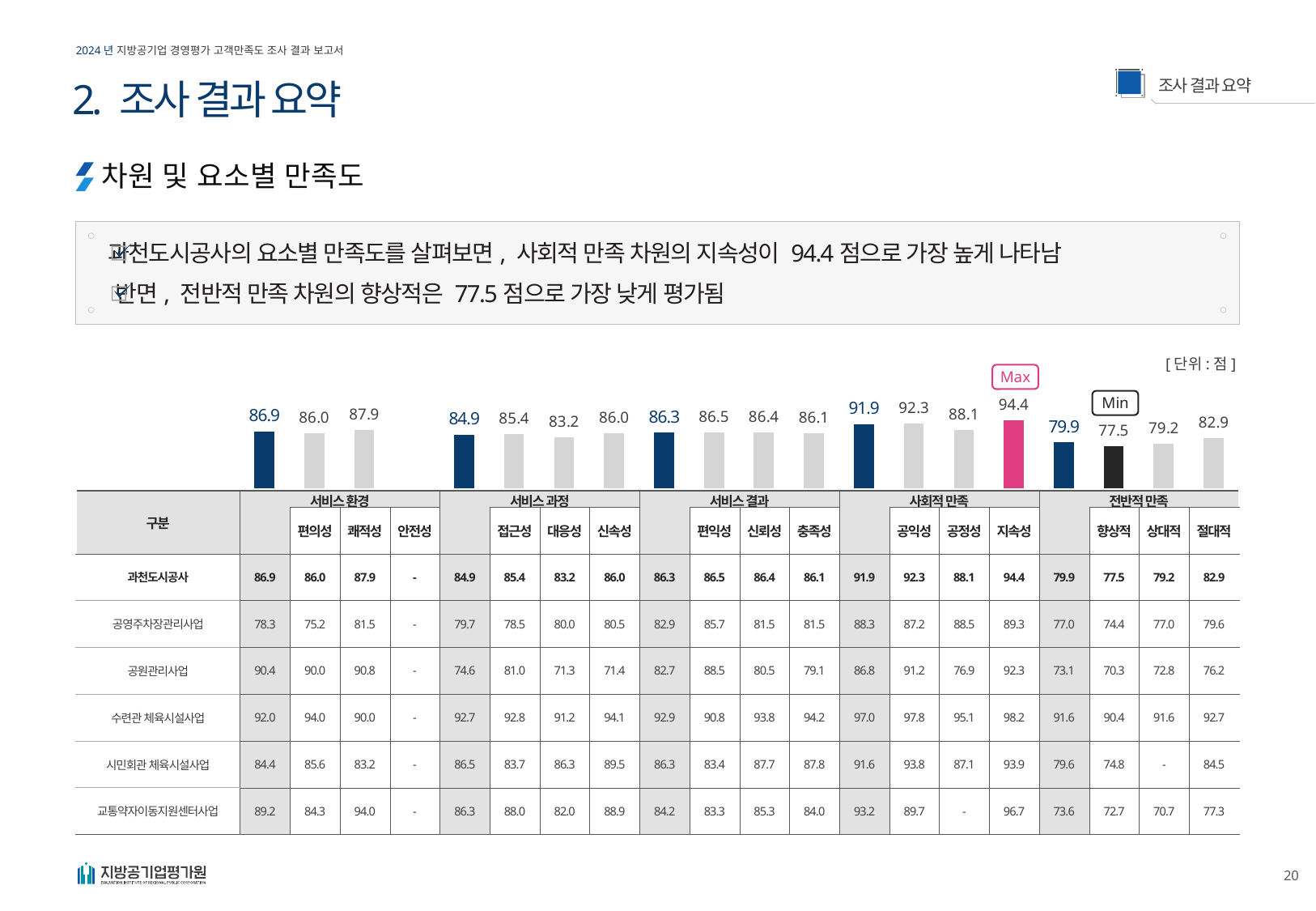
Which element has the lowest bar in the chart? 향상적 What is the difference between the highest bar (지속성) and the lowest bar (향상적)? 16.9 Which is larger, the bar for 쾌적성 or the bar for 편의성? 쾌적성 What is the value of the bar for 향상적 (전반적 만족)? 77.5 What is the value of the bar for 서비스 과정? 84.9 Among the five dimension bars (서비스 환경, 서비스 과정, 서비스 결과, 사회적 만족, 전반적 만족), which has the highest value? 사회적 만족 Which element has the highest bar in the chart? 지속성 What is the value of the bar for 지속성 (사회적 만족)? 94.4 What is the difference between the bars for 공익성 and 공정성? 4.2 What unit is indicated for the chart values? 점 How many bars are plotted in the chart? 19 What kind of chart is shown on the slide? bar chart